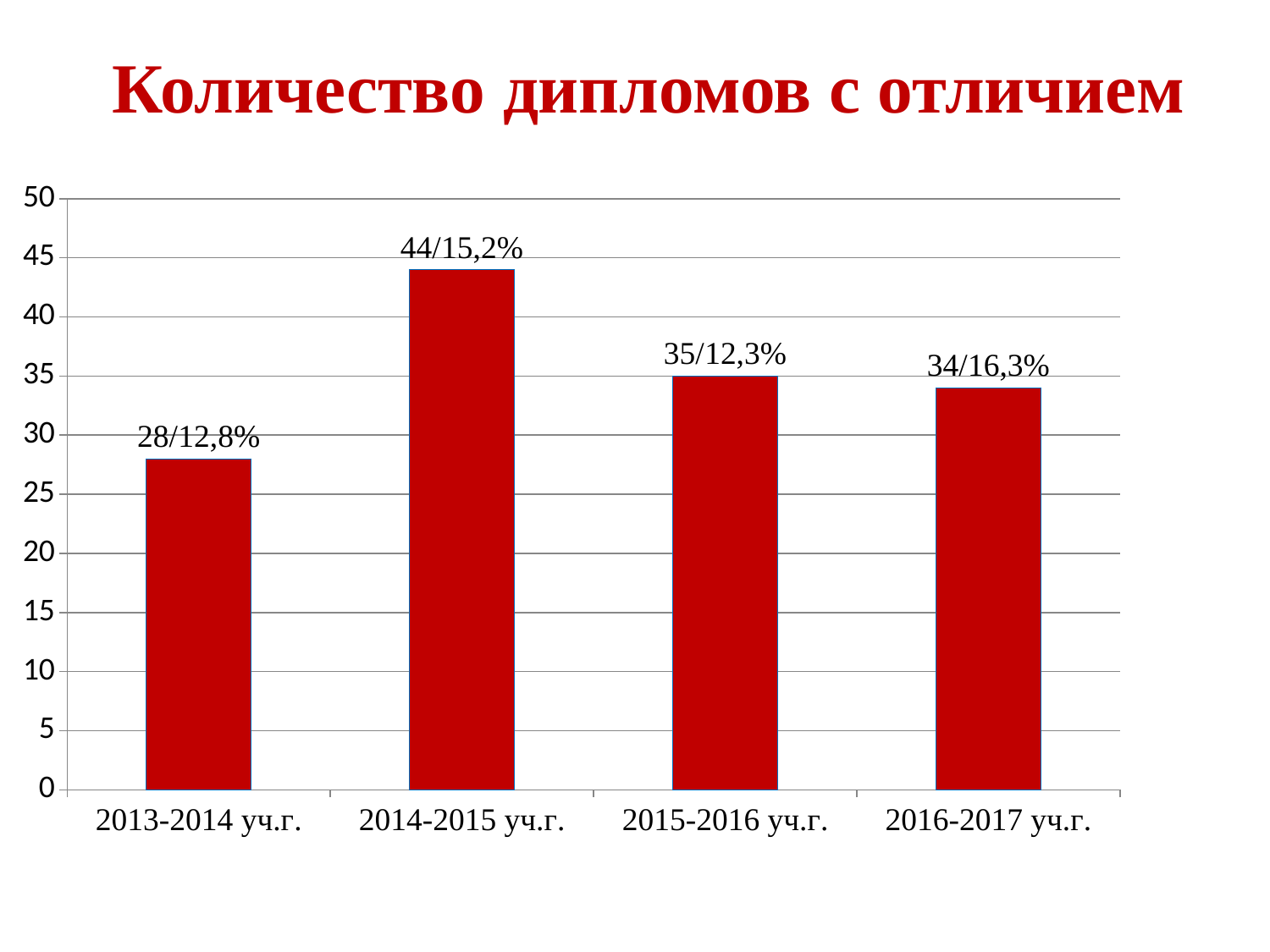
What kind of chart is shown on the slide? bar chart What is the title of the chart? Количество дипломов с отличием What is the data label shown for 2013-2014 уч.г.? 28/12,8% Which has more diplomas with distinction: 2015-2016 уч.г. or 2016-2017 уч.г.? 2015-2016 уч.г. What is the data label shown for 2014-2015 уч.г.? 44/15,2% What is the data label shown for 2016-2017 уч.г.? 34/16,3% What is the difference in the number of diplomas between 2014-2015 уч.г. and 2013-2014 уч.г.? 16 Which academic year has the lowest number of diplomas with distinction? 2013-2014 уч.г. How many academic years are shown on the chart? 4 Is the number of diplomas for 2013-2014 уч.г. greater or less than 30? less Which academic year has the highest number of diplomas with distinction? 2014-2015 уч.г. What is the data label shown for 2015-2016 уч.г.? 35/12,3%